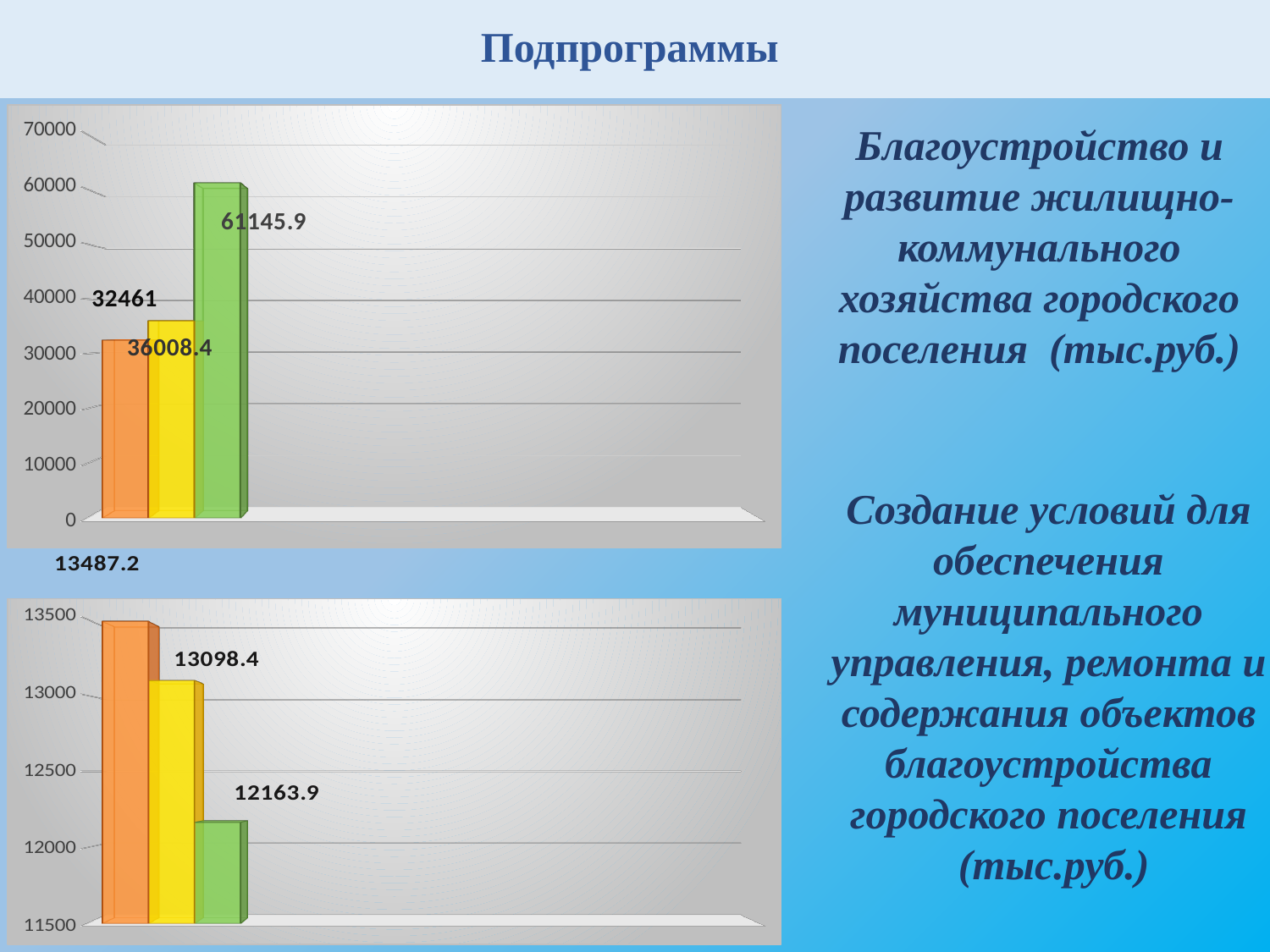
On the bottom chart, is the value of the green bar greater or less than 12500? less On the top chart, do the values rise or fall from left to right? Rise On the bottom chart, what is the value of the green bar? 12163.9 On the top chart, which bar has the highest value? The green bar On the top chart, what is the value of the orange bar? 32461 On the top chart, what is the difference between the green bar and the orange bar? 28684.9 On the bottom chart, which bar has the lowest value? The green bar On the top chart, what is the value of the green bar? 61145.9 On the top chart, what is the value of the yellow bar? 36008.4 On the bottom chart, what is the value of the yellow bar? 13098.4 On the bottom chart, what is the difference between the orange bar (13487.2) and the green bar? 1323.3 How many bars are plotted on the bottom chart? 3